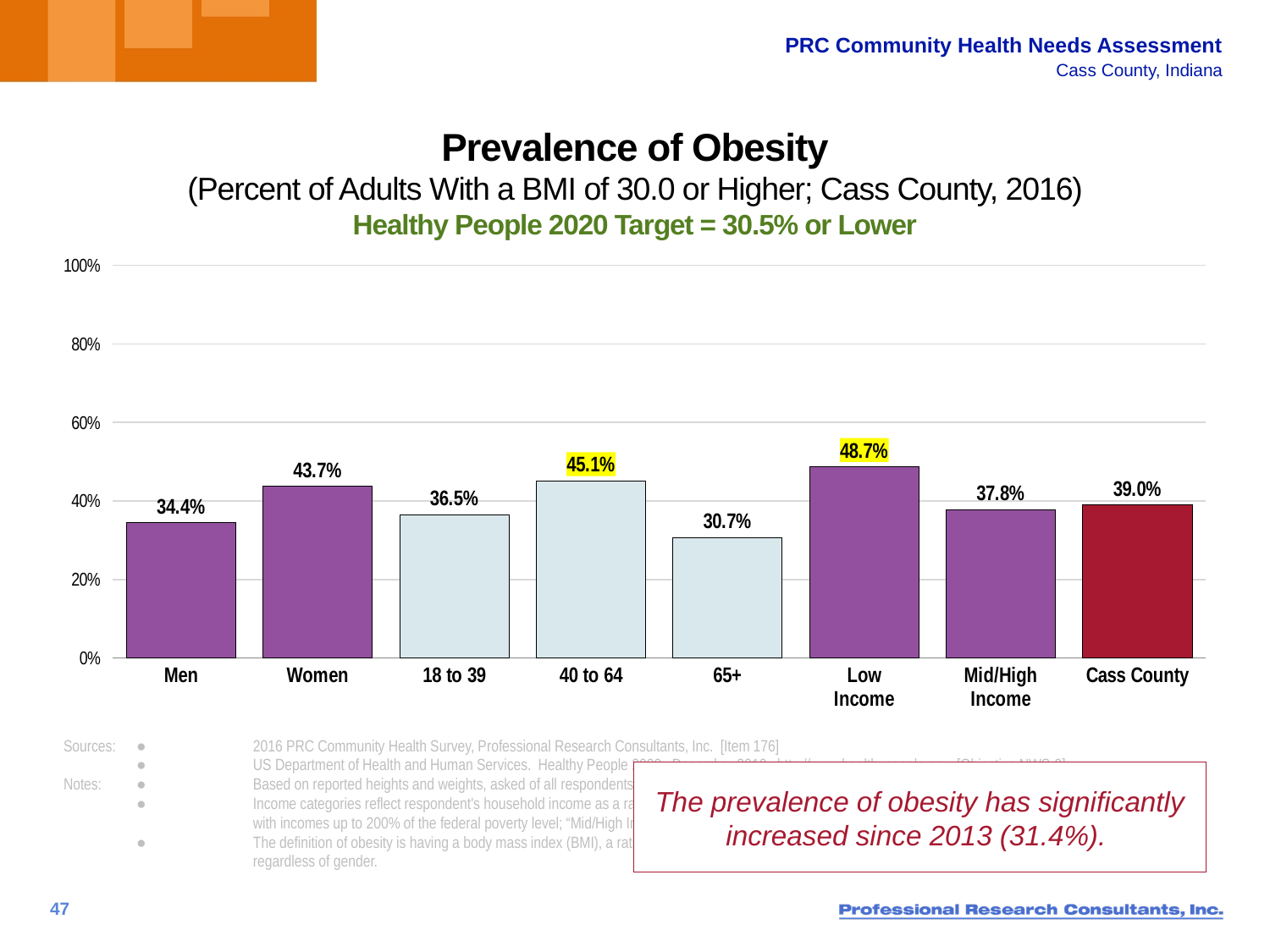
Which category has the highest prevalence of obesity? Low Income What is the difference between the values for Women and Men? 9.3% Which is larger, the value for 40 to 64 or the value for 18 to 39? 40 to 64 Is the value for Women greater or less than 40%? greater What is the value for Cass County overall? 39.0% What kind of chart is shown on the slide? bar chart Which category has the lowest prevalence of obesity? 65+ What is the difference between the values for Low Income and Mid/High Income? 10.9% What is the Healthy People 2020 Target stated on the slide? 30.5% or Lower What is the prevalence of obesity for Men? 34.4% How many categories are shown on the chart? 8 What is the prevalence of obesity for Low Income adults? 48.7%